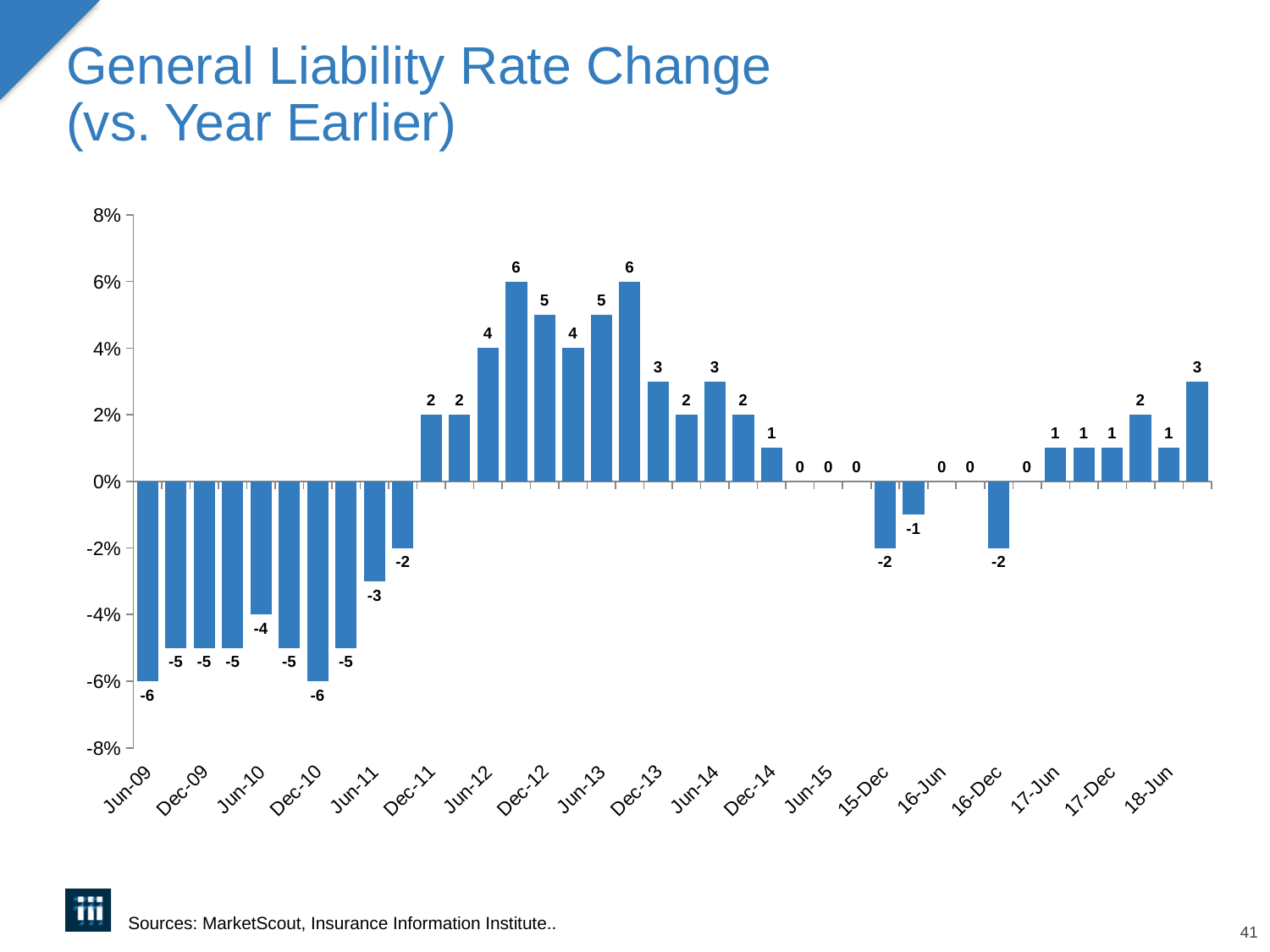
What is the value for Jun-09? -6 What is the difference between the value for 15-Dec and the value for Jun-09? 4 What is the value for Dec-14? 1 What is the value for Jun-15? 0 What is the title of the chart? General Liability Rate Change (vs. Year Earlier) Do the values rise or fall from Jun-09 to Dec-11? rise Which is larger, the value for Dec-14 or the value for 15-Dec? Dec-14 What is the highest value shown in the chart? 6 What is the value for 15-Dec? -2 What type of chart is shown on the slide? bar chart What is the lowest value shown in the chart? -6